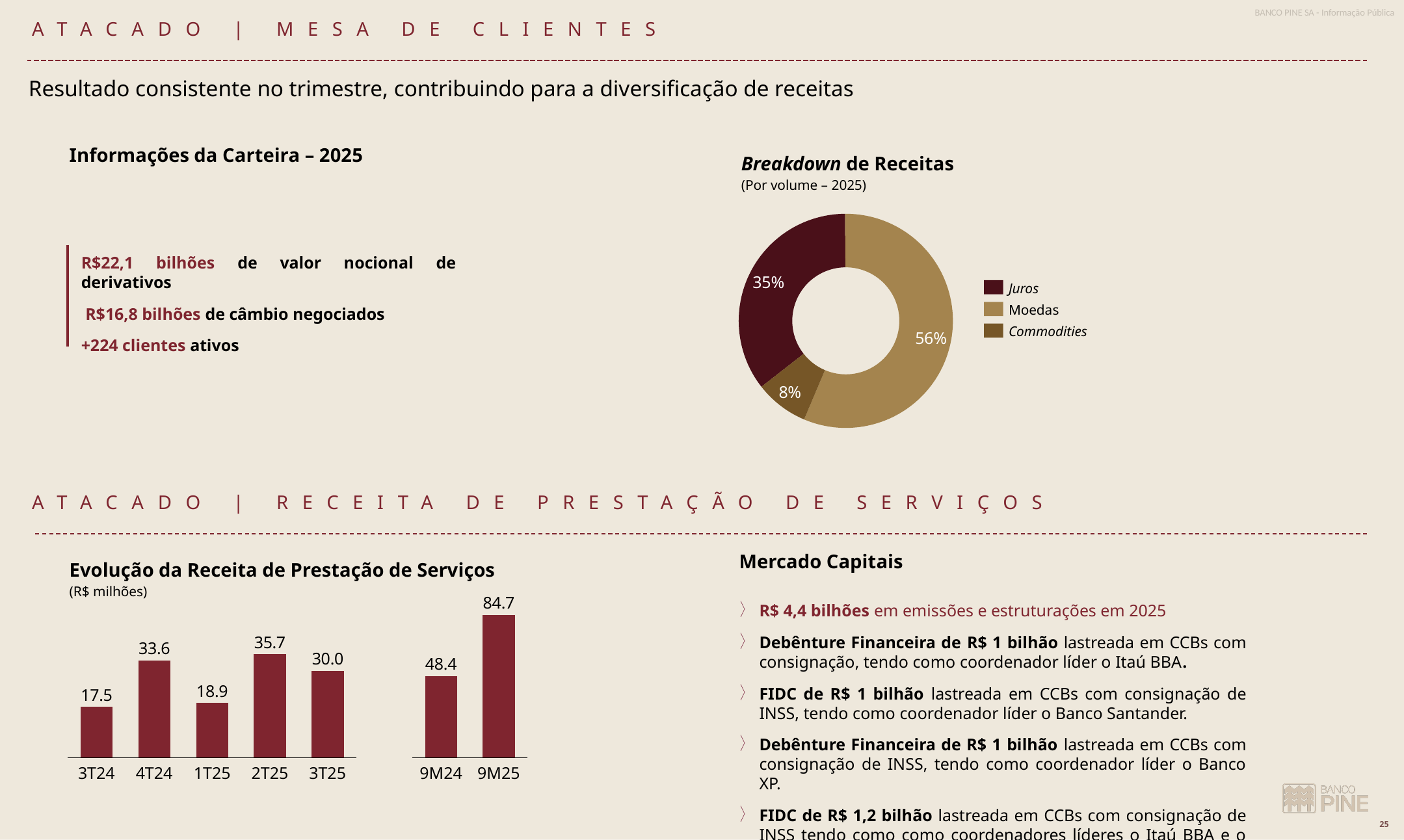
In the 'Breakdown de Receitas' chart, what share of revenue comes from Juros? 35% In the 'Breakdown de Receitas' chart, how many categories does the legend list? 3 What kind of chart is 'Evolução da Receita de Prestação de Serviços'? Bar chart In the 'Evolução da Receita de Prestação de Serviços' chart, how many bars are plotted in total? 7 What kind of chart is 'Breakdown de Receitas'? Donut (pie) chart In the 'Evolução da Receita de Prestação de Serviços' chart, what is the difference between 9M25 and 9M24? 36.3 In the 'Breakdown de Receitas' chart, what share of revenue comes from Moedas? 56% In the 'Evolução da Receita de Prestação de Serviços' chart, what is the value for 2T25? 35.7 In the 'Breakdown de Receitas' chart, which category has the smallest share? Commodities In the 'Evolução da Receita de Prestação de Serviços' chart, which is larger, 4T24 or 3T25? 4T24 In the 'Evolução da Receita de Prestação de Serviços' chart, what is the value for 9M25? 84.7 In the 'Evolução da Receita de Prestação de Serviços' chart, which quarter has the lowest value? 3T24